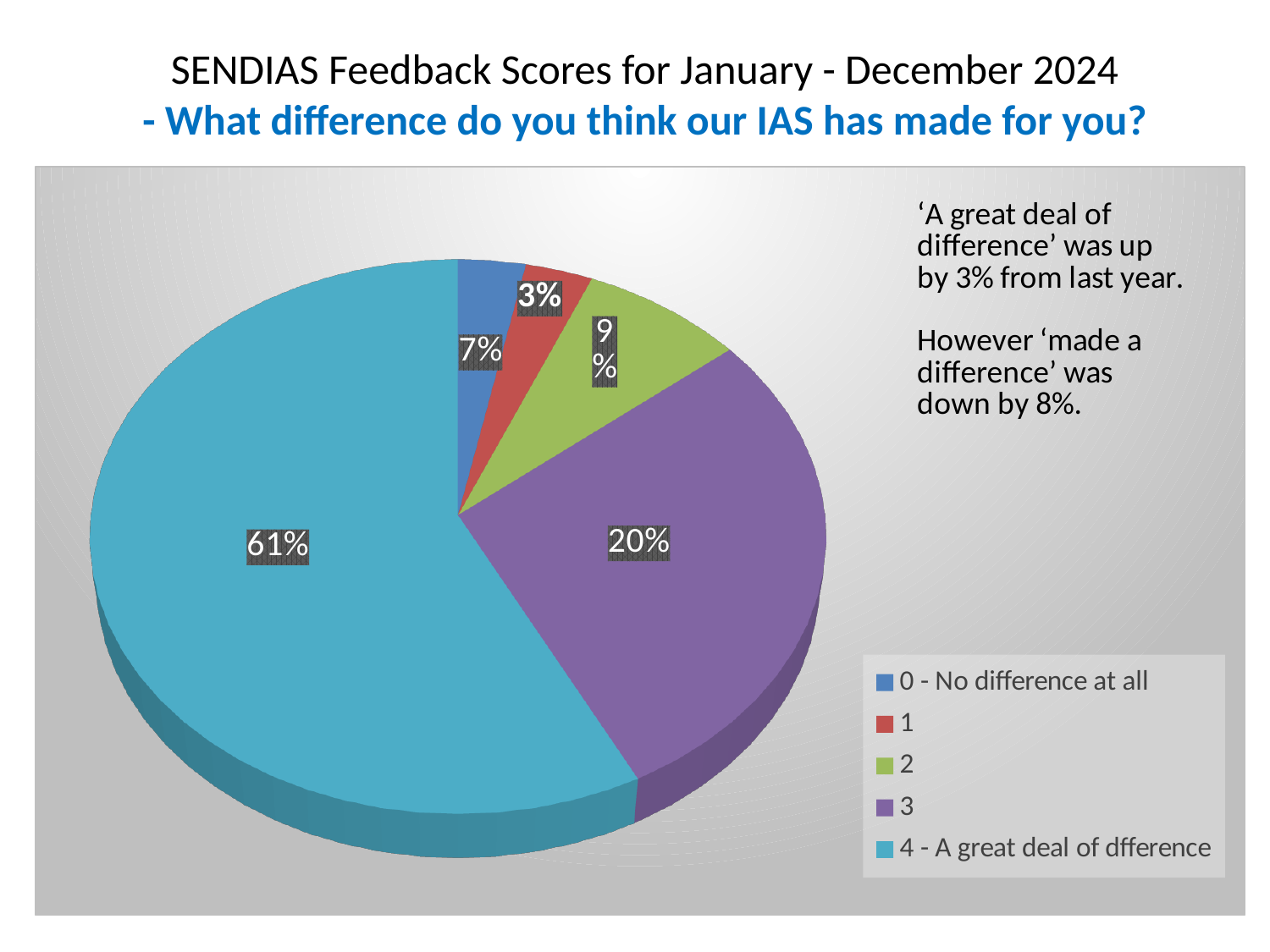
What colour is the slice for '4 - A great deal of dfference'? teal/light blue Which is larger, the slice for '0 - No difference at all' or the slice for category '2'? 2 What share of the pie is '4 - A great deal of dfference'? 61% What share of the pie is category '2'? 9% What share of the pie is category '3'? 20% Which category has the largest slice of the pie? 4 - A great deal of dfference What kind of chart is shown on the slide? pie chart How many categories does the pie chart have? 5 Which category has the smallest slice of the pie? 1 What is the difference in percentage points between category '3' and category '2'? 11